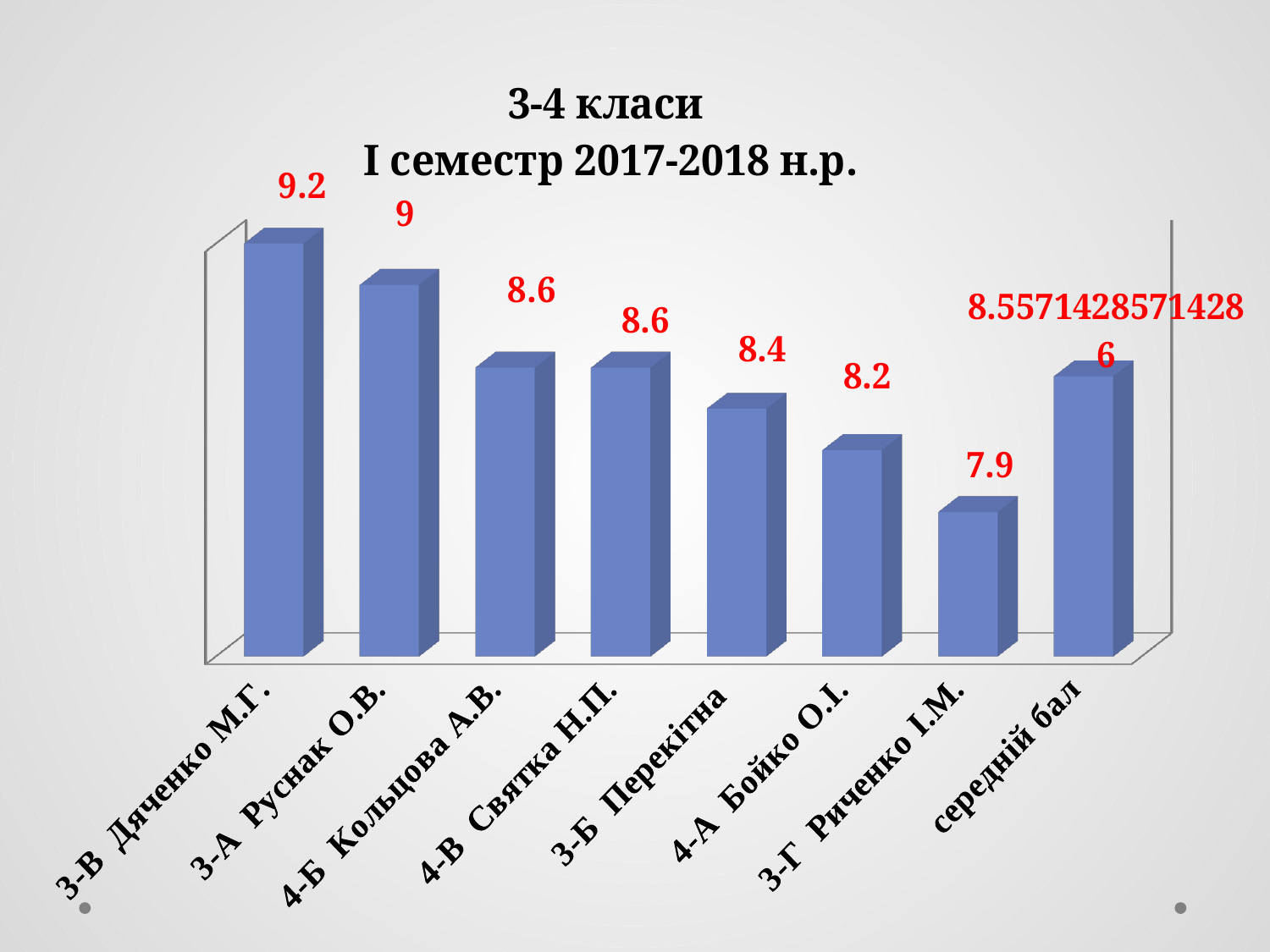
Which category has the lowest value? 3-Г Риченко І.М. What is the difference between the values for 3-В Дяченко М.Г. and 3-Г Риченко І.М.? 1.3 What is the value for 3-Б Перекітна? 8.4 What is the value for 3-В Дяченко М.Г.? 9.2 Which category has the highest value? 3-В Дяченко М.Г. What is the value for 3-Г Риченко І.М.? 7.9 What kind of chart is shown on the slide? bar chart How many bars are shown in the chart? 8 What is the title of the chart? 3-4 класи І семестр 2017-2018 н.р. Which is larger, the value for 3-А Руснак О.В. or the value for 4-А Бойко О.І.? 3-А Руснак О.В. What is the value for 4-А Бойко О.І.? 8.2 What is the value for 3-А Руснак О.В.? 9